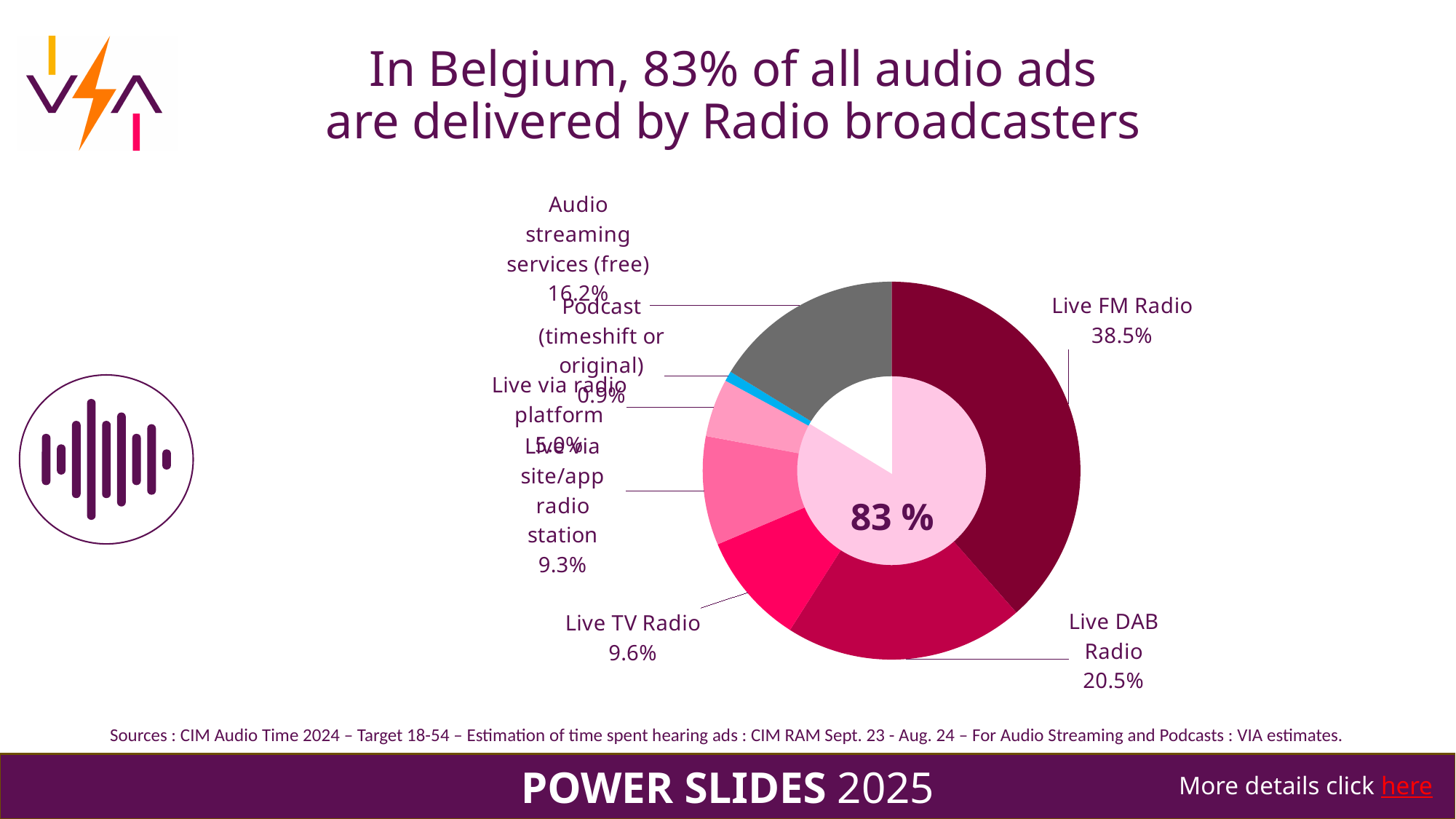
Which category has the largest slice of the pie? Live FM Radio What kind of chart is shown on the slide? Pie chart (donut) What share of audio ads is delivered by Audio streaming services (free)? 16.2% What share of audio ads is delivered by Live TV Radio? 9.6% What share of audio ads is delivered by Live DAB Radio? 20.5% What value is printed in the centre of the donut chart? 83 % Which is larger: the share for Live DAB Radio or for Audio streaming services (free)? Live DAB Radio What share of audio ads is delivered by Live FM Radio? 38.5% What is the difference between the shares of Live FM Radio and Live DAB Radio? 18.0% What share of audio ads is delivered by Live via site/app radio station? 9.3% Which category has the smallest slice of the pie? Podcast (timeshift or original) How many categories are shown in the pie chart? 7